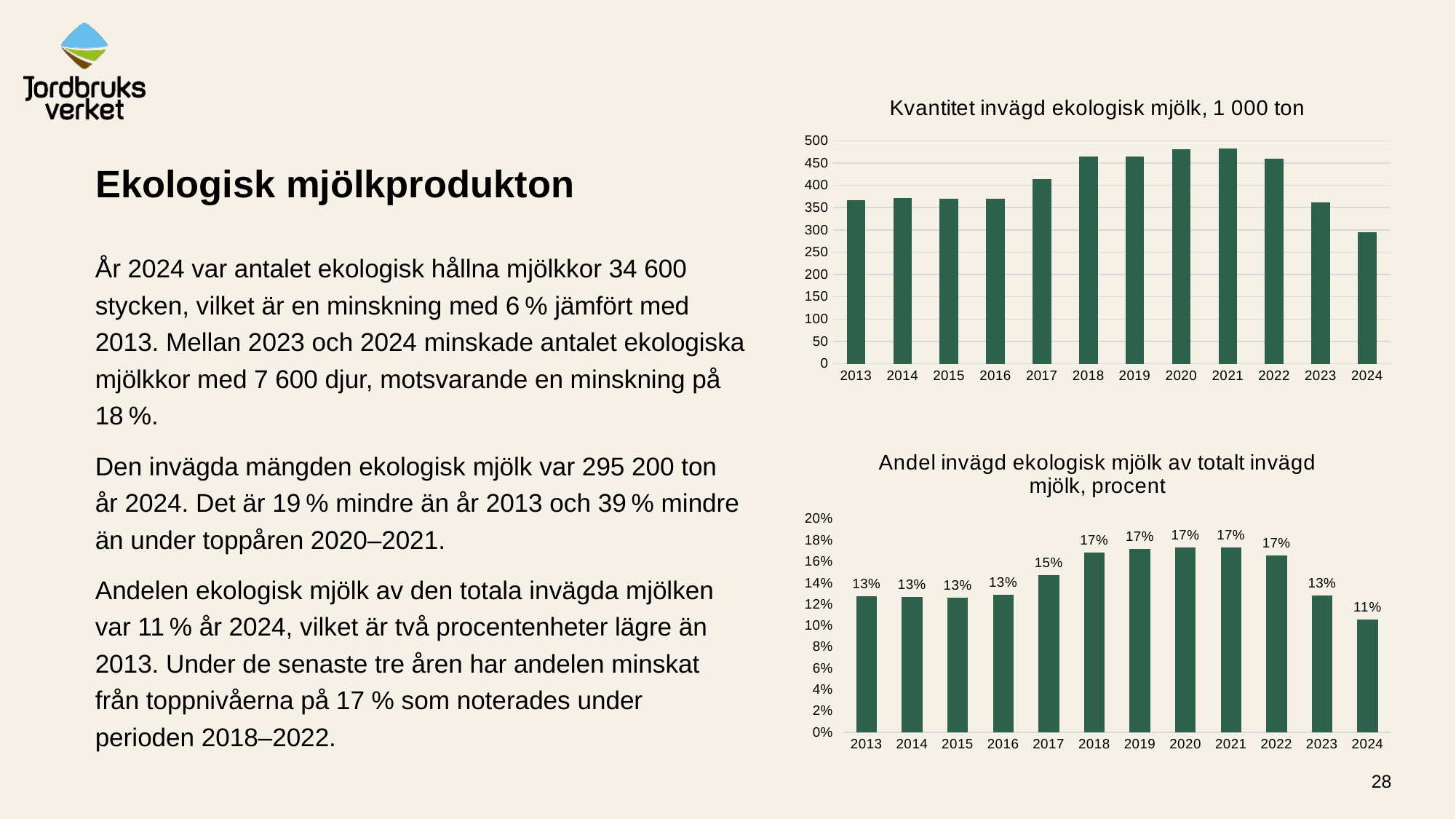
In the top chart 'Kvantitet invägd ekologisk mjölk, 1 000 ton', which year has the lowest value? 2024 In the bottom chart 'Andel invägd ekologisk mjölk av totalt invägd mjölk, procent', which year has the lowest value? 2024 In the bottom chart 'Andel invägd ekologisk mjölk av totalt invägd mjölk, procent', what is the value for 2024? 11% In the top chart 'Kvantitet invägd ekologisk mjölk, 1 000 ton', which is larger, the value for 2013 or the value for 2018? 2018 How many years are shown on the x axis of the top chart 'Kvantitet invägd ekologisk mjölk, 1 000 ton'? 12 In the bottom chart 'Andel invägd ekologisk mjölk av totalt invägd mjölk, procent', do the values rise or fall from 2022 to 2024? fall In the bottom chart 'Andel invägd ekologisk mjölk av totalt invägd mjölk, procent', what is the value for 2017? 15% In the top chart 'Kvantitet invägd ekologisk mjölk, 1 000 ton', is the value for 2023 greater or less than 350? greater What type of chart is the top chart, 'Kvantitet invägd ekologisk mjölk, 1 000 ton'? bar chart In the top chart 'Kvantitet invägd ekologisk mjölk, 1 000 ton', is the value for 2017 greater or less than 400? greater What is the title of the top chart on the slide? Kvantitet invägd ekologisk mjölk, 1 000 ton In the bottom chart 'Andel invägd ekologisk mjölk av totalt invägd mjölk, procent', what is the difference between the values for 2018 and 2024? 6 percentage points